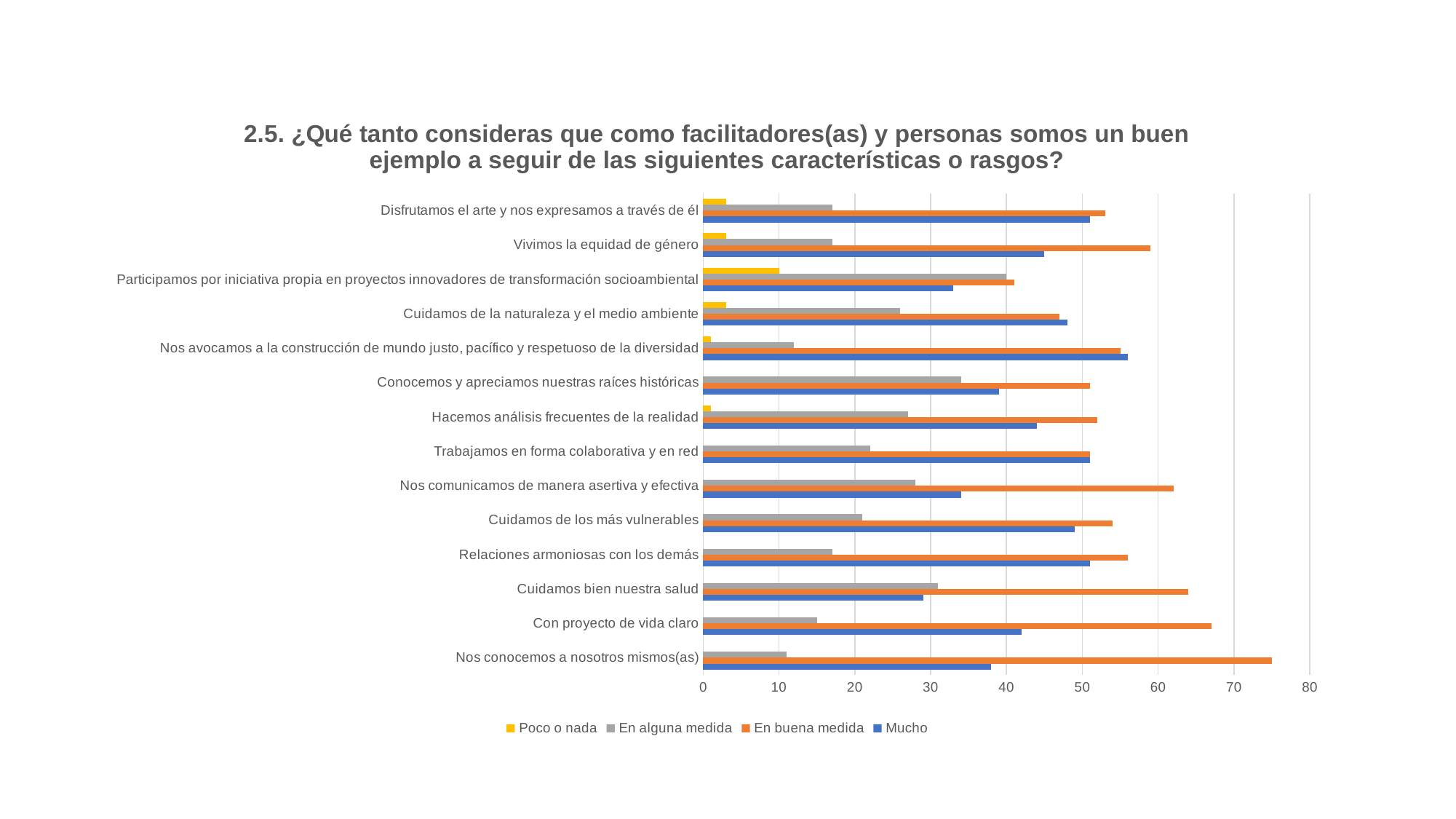
How many characteristics (categories) are listed on the chart? 14 For 'Nos comunicamos de manera asertiva y efectiva', which is larger: 'En buena medida' or 'Mucho'? En buena medida Is the 'Mucho' value for 'Cuidamos bien nuestra salud' greater or less than 40? less How many series does the legend list? 4 What kind of chart is shown on the slide? Bar chart Is the 'En buena medida' value for 'Nos conocemos a nosotros mismos(as)' greater or less than 70? greater Which category has the highest value for 'Poco o nada'? Participamos por iniciativa propia en proyectos innovadores de transformación socioambiental Is the 'Mucho' value for 'Nos avocamos a la construcción de mundo justo, pacífico y respetuoso de la diversidad' greater or less than 50? greater For 'Con proyecto de vida claro', which is larger: 'Mucho' or 'En alguna medida'? Mucho What colour represents the 'Mucho' series in the legend? Blue Which category has the highest value for 'En buena medida'? Nos conocemos a nosotros mismos(as)